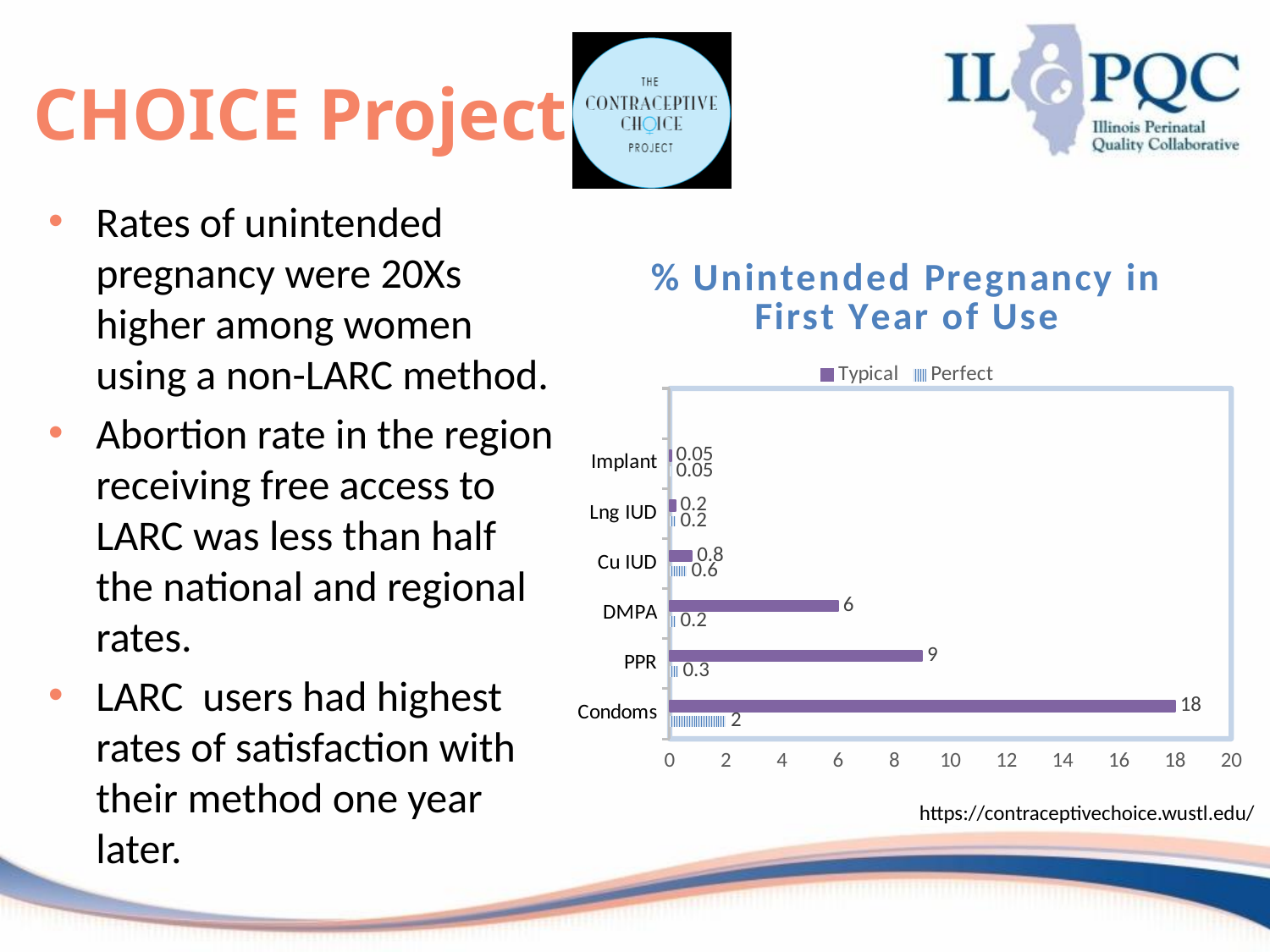
Which is larger, the Typical value for DMPA or the Typical value for PPR? PPR Which category has the highest Typical value? Condoms What is the Typical value for Condoms? 18 What is the Perfect value for Cu IUD? 0.6 What is the difference between the Typical and Perfect values for Condoms? 16 How many categories are shown on the chart? 6 What is the title of the chart? % Unintended Pregnancy in First Year of Use What is the Perfect value for DMPA? 0.2 What is the Typical value for PPR? 9 What kind of chart is shown? Bar chart Which category has the lowest Typical value? Implant How many series does the legend list? 2